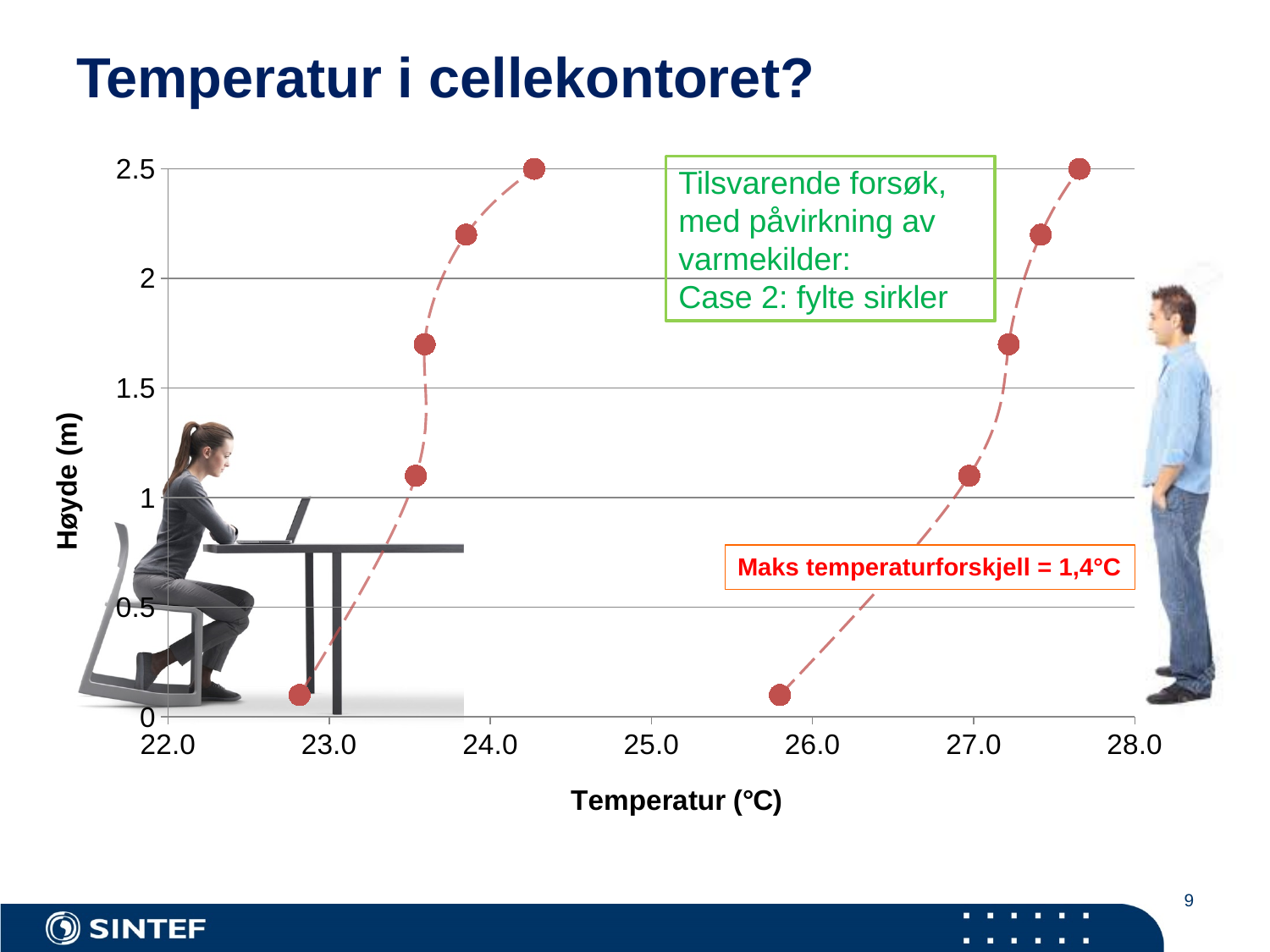
At a height of 2.5 m, which curve shows the higher temperature, the left-hand or the right-hand one? the right-hand curve Along each curve, does the temperature rise or fall as the height increases? rise Is the temperature of the left-hand curve's point at about 1 m height greater or less than 24.0? less What is the title of the y axis? Høyde (m) Is the temperature of the lowest point on the right-hand curve greater or less than 26.0? less Is the temperature of the highest point (at 2.5 m) on the left-hand curve greater or less than 24.0? greater How many data points does the right-hand curve have? 5 What is the title of the x axis? Temperatur (°C) What kind of chart is shown on the slide? scatter chart with dashed lines How many data points does the left-hand curve have? 5